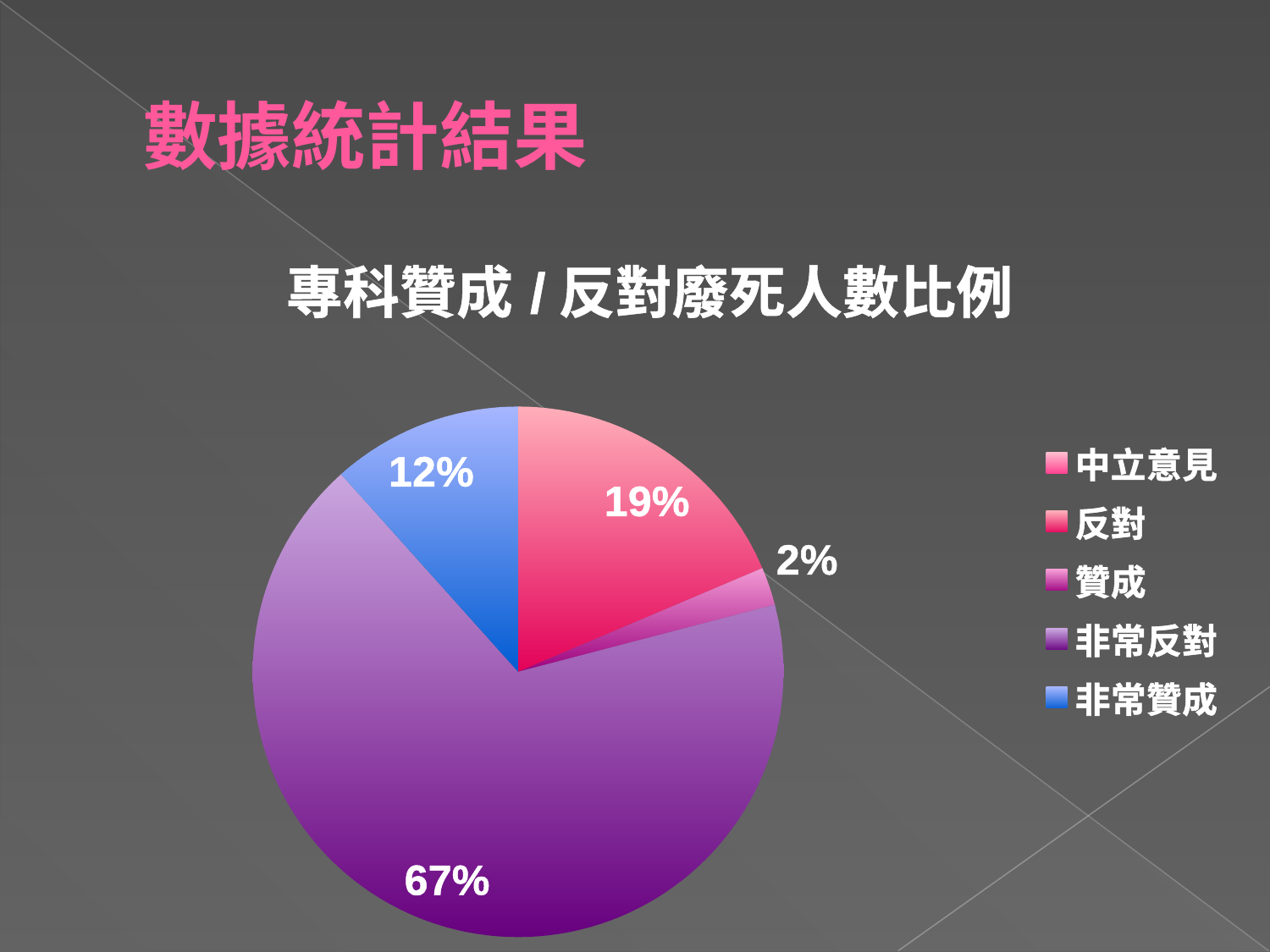
What percentage is shown for 非常贊成? 12% What percentage is shown for 非常反對? 67% What is the title of the chart? 專科贊成 / 反對廢死人數比例 Which category has the largest slice of the pie? 非常反對 Which labeled slice is the smallest in the pie? 贊成 Which is larger, the slice for 反對 or the slice for 非常贊成? 反對 What is the difference in percentage points between 非常反對 and 非常贊成? 55 How many entries does the chart's legend list? 5 What colour is the slice for 非常贊成? blue What percentage is shown for 贊成? 2% What percentage is shown for 反對? 19% What type of chart is shown on the slide? pie chart